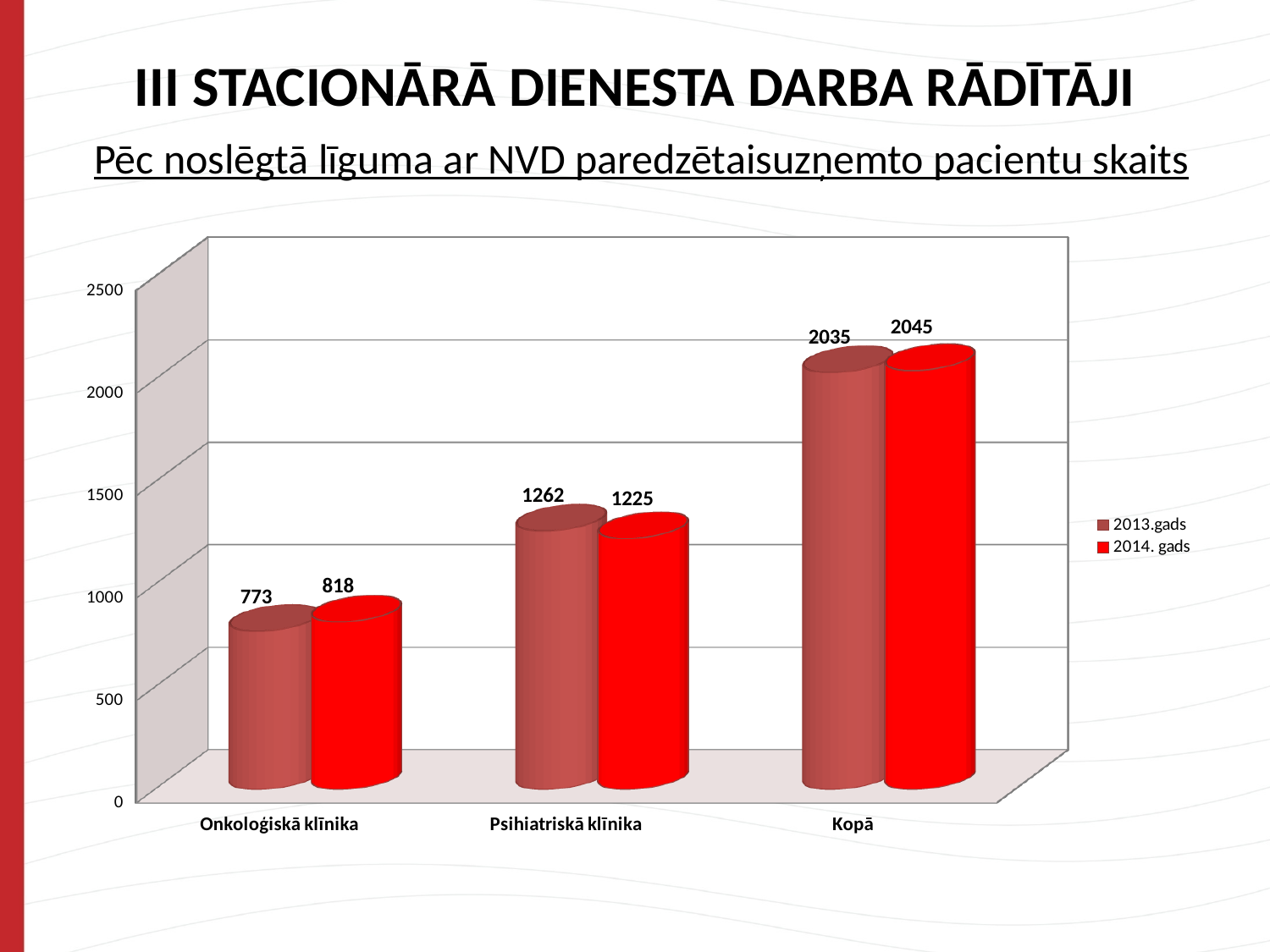
Which category has the highest value in the 2014. gads series? Kopā What is the value for Kopā in 2013.gads? 2035 Which category has the lowest value in the 2013.gads series? Onkoloģiskā klīnika How many series does the legend list? 2 What is the value for Onkoloģiskā klīnika in 2013.gads? 773 Is the value for Kopā in 2014. gads greater or less than 2000? greater What kind of chart is shown on the slide? bar chart How many categories are shown on the x axis? 3 What is the difference between the 2014. gads and 2013.gads values for Onkoloģiskā klīnika? 45 Which is larger for Psihiatriskā klīnika: the 2013.gads value or the 2014. gads value? 2013.gads What is the value for Psihiatriskā klīnika in 2014. gads? 1225 What is the difference between the 2013.gads and 2014. gads values for Psihiatriskā klīnika? 37